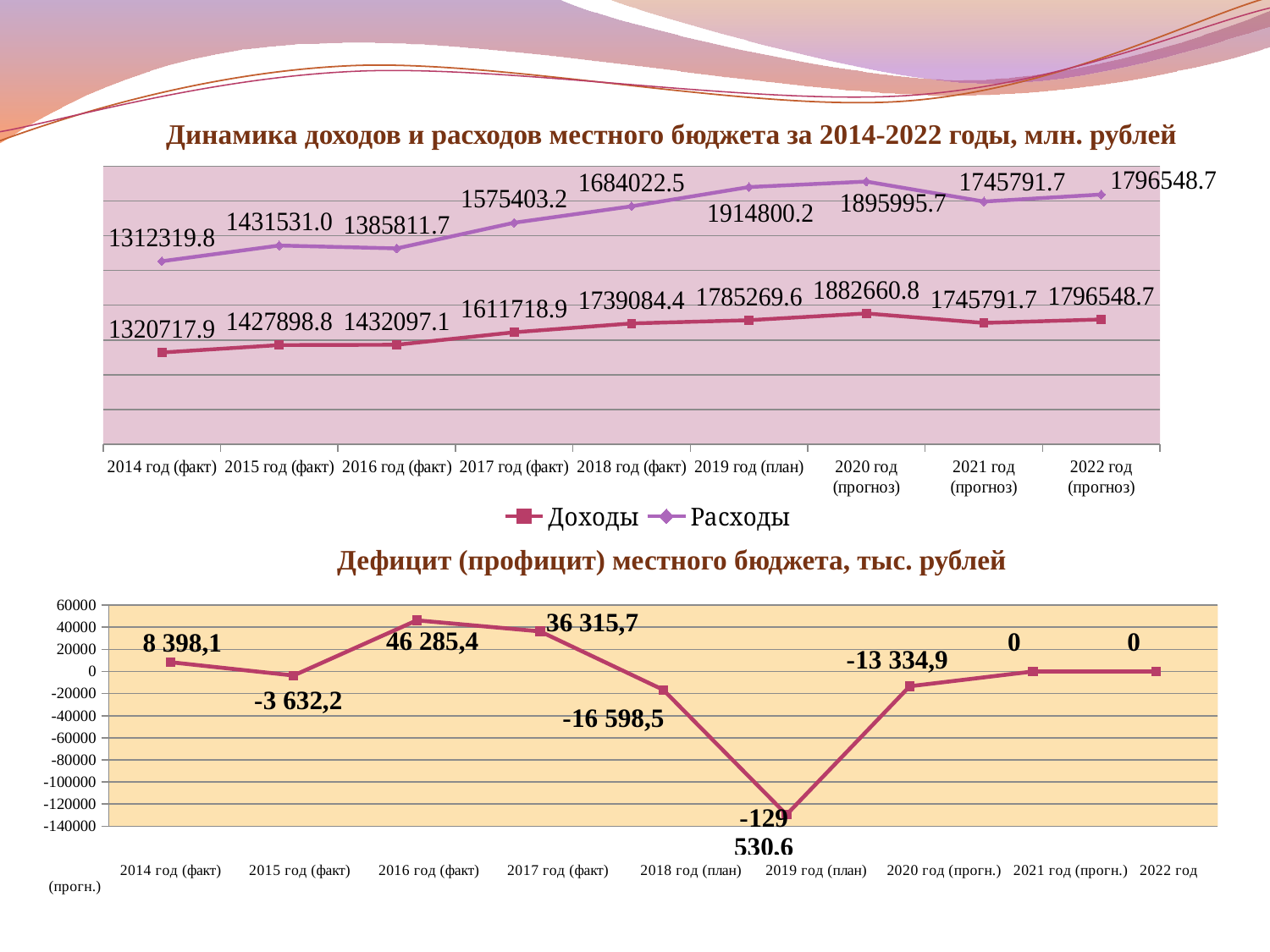
In the top chart 'Динамика доходов и расходов местного бюджета', what is the value of Расходы for 2019 год (план)? 1914800.2 In the top chart 'Динамика доходов и расходов местного бюджета', which is larger for 2019 год (план): Доходы or Расходы? Расходы In the top chart 'Динамика доходов и расходов местного бюджета', in which year is Доходы highest? 2020 год (прогноз) In the top chart 'Динамика доходов и расходов местного бюджета', what is the value of Доходы for 2017 год (факт)? 1611718.9 In the top chart 'Динамика доходов и расходов местного бюджета', do the Доходы values rise or fall from 2014 год (факт) to 2017 год (факт)? rise In the top chart 'Динамика доходов и расходов местного бюджета', what is the difference between Доходы and Расходы for 2014 год (факт)? 8398.1 How many series does the legend of the top chart 'Динамика доходов и расходов местного бюджета' list? 2 How many year categories are shown on the x axis of the top chart 'Динамика доходов и расходов местного бюджета'? 9 In the bottom chart 'Дефицит (профицит) местного бюджета', which year has the lowest value? 2019 год (план) In the bottom chart 'Дефицит (профицит) местного бюджета', what is the value for 2020 год (прогн.)? -13 334,9 What kind of chart is the bottom chart 'Дефицит (профицит) местного бюджета'? line chart In the bottom chart 'Дефицит (профицит) местного бюджета', which year has the highest value? 2016 год (факт)